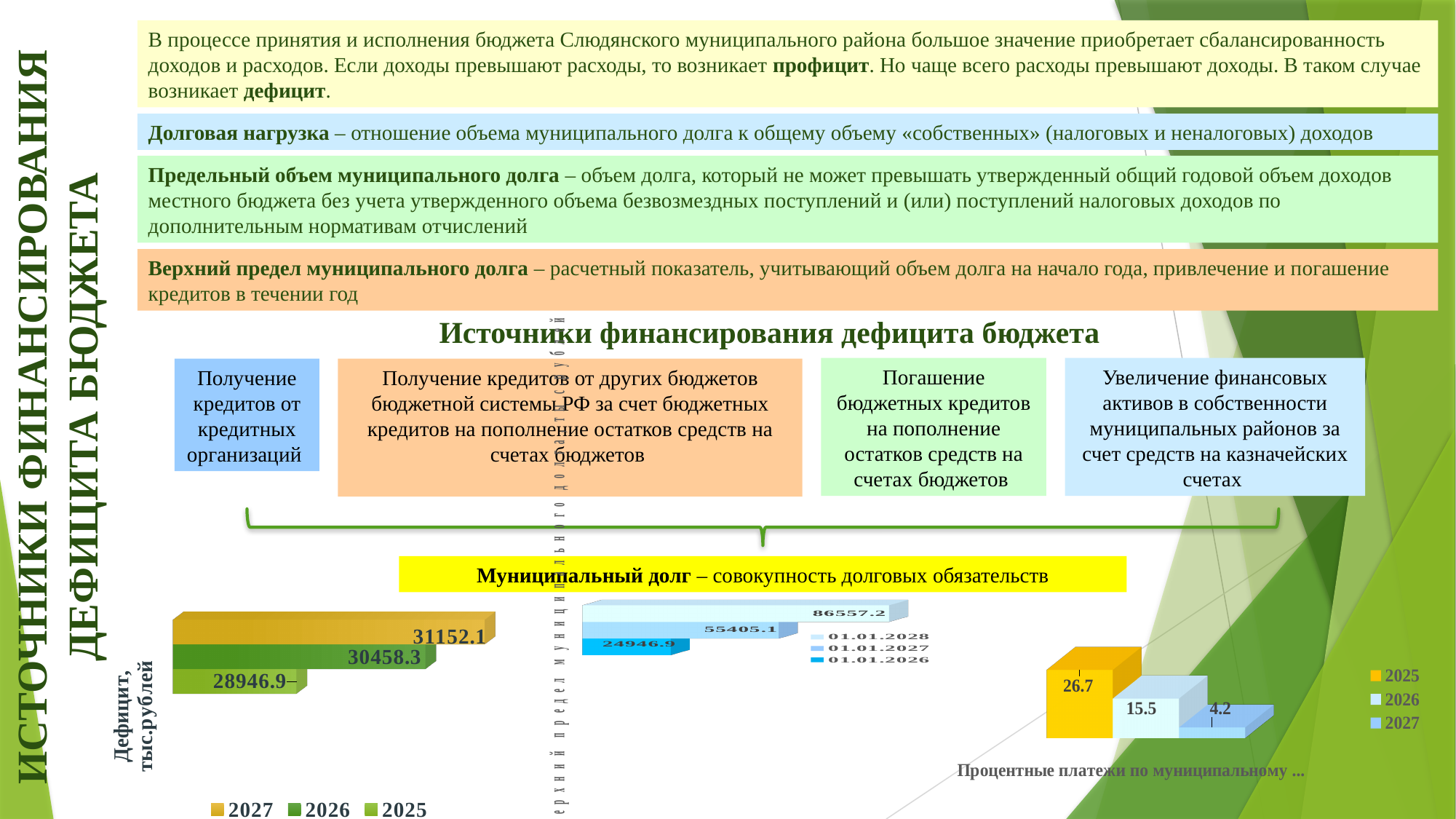
On the right chart (Процентные платежи по муниципальному ...), which year has the highest value? 2025 On the left chart (Дефицит, тыс.рублей), what is the value for 2027? 31152.1 On the middle chart, what is the value for 01.01.2028? 86557.2 On the right chart (Процентные платежи по муниципальному ...), what is the value for 2026? 15.5 On the middle chart, which date has the highest value? 01.01.2028 On the middle chart, what is the difference between the 01.01.2027 and 01.01.2026 values? 30458.2 On the left chart (Дефицит, тыс.рублей), which year has the lowest value? 2025 On the middle chart, what is the value for 01.01.2026? 24946.9 On the left chart (Дефицит, тыс.рублей), what is the value for 2025? 28946.9 On the left chart (Дефицит, тыс.рублей), how many years does the legend list? 3 On the left chart (Дефицит, тыс.рублей), what is the difference between the 2027 and 2026 values? 693.8 On the right chart (Процентные платежи по муниципальному ...), do the values rise or fall from 2025 to 2027? fall